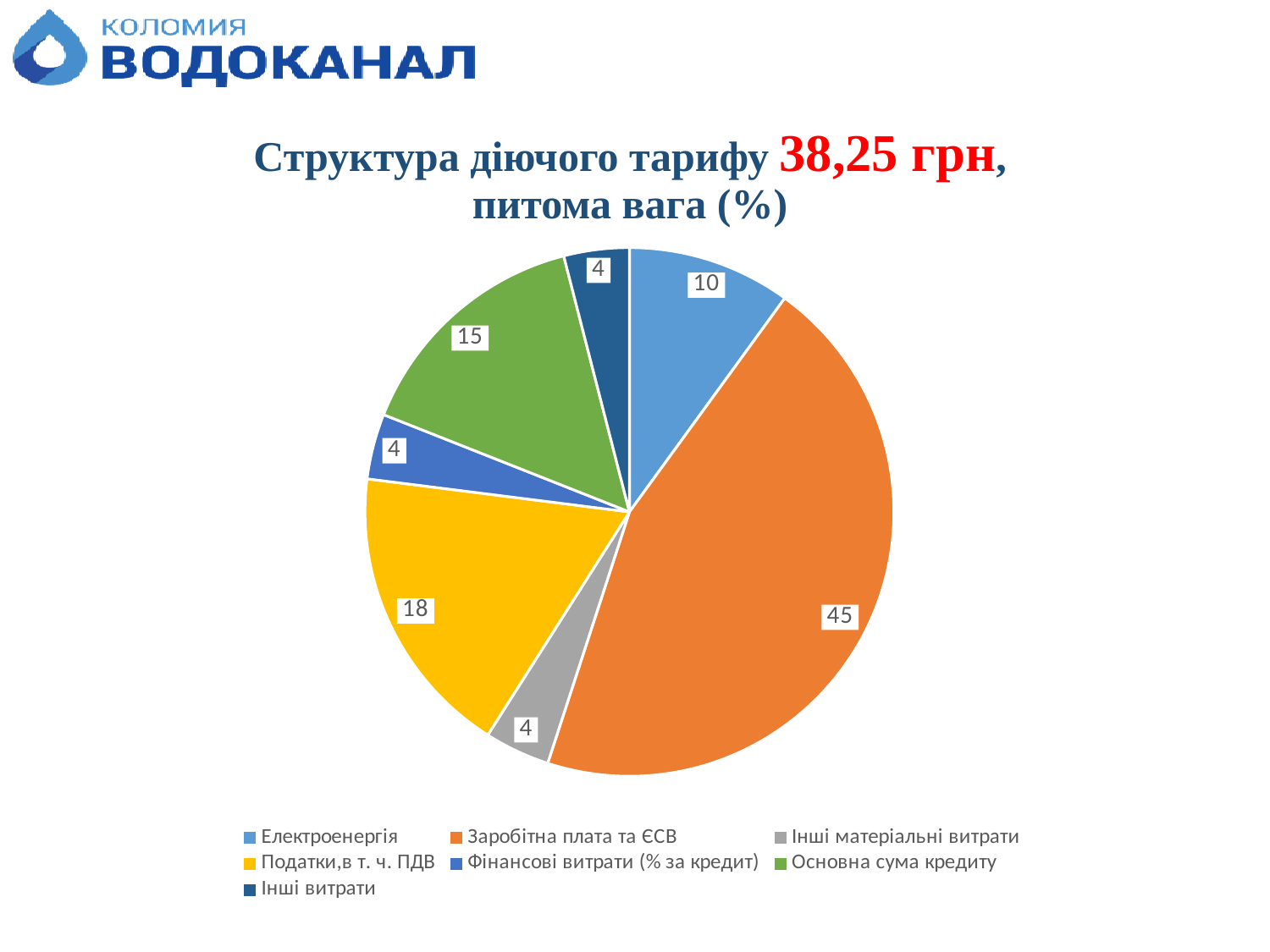
What is the value for Податки,в т. ч. ПДВ? 18 Which is larger, the value for Основна сума кредиту or the value for Електроенергія? Основна сума кредиту Which category has the largest slice of the pie? Заробітна плата та ЄСВ What is the difference between the values for Заробітна плата та ЄСВ and Податки,в т. ч. ПДВ? 27 How many categories does the legend list? 7 What kind of chart is shown on the slide? pie chart What tariff amount is stated in the chart title? 38,25 грн What is the value for Електроенергія? 10 What is the value for Заробітна плата та ЄСВ? 45 How many slices does the pie chart have? 7 What is the value for Фінансові витрати (% за кредит)? 4 What is the value for Основна сума кредиту? 15